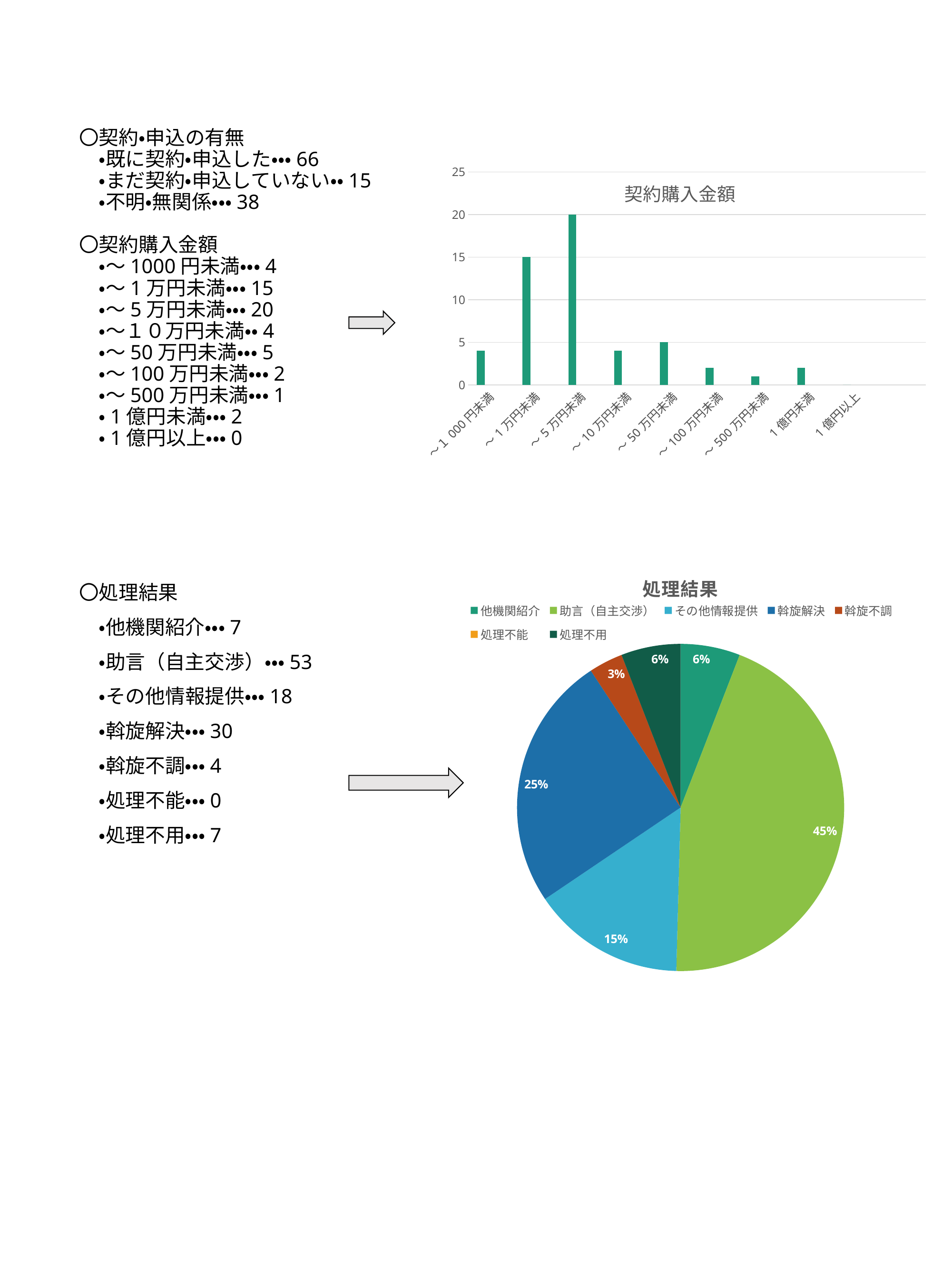
In the 契約購入金額 chart, what is the value for ～5万円未満? 20 In the 処理結果 pie chart, what share does 斡旋解決 have? 25% How many entries does the legend of the 処理結果 pie chart list? 7 In the 契約購入金額 chart, is the value for ～1000円未満 greater or less than 5? less In the 処理結果 pie chart, what share does 助言（自主交渉） have? 45% In the 契約購入金額 chart, what is the value for ～1万円未満? 15 How many categories are shown on the x axis of the 契約購入金額 chart? 9 What kind of chart is the 処理結果 chart? pie chart In the 契約購入金額 chart, which category has the highest value? ～5万円未満 In the 契約購入金額 chart, what is the difference between the values for ～5万円未満 and ～1万円未満? 5 In the 契約購入金額 chart, which is larger, the value for ～50万円未満 or ～100万円未満? ～50万円未満 What kind of chart is the 契約購入金額 chart? bar chart